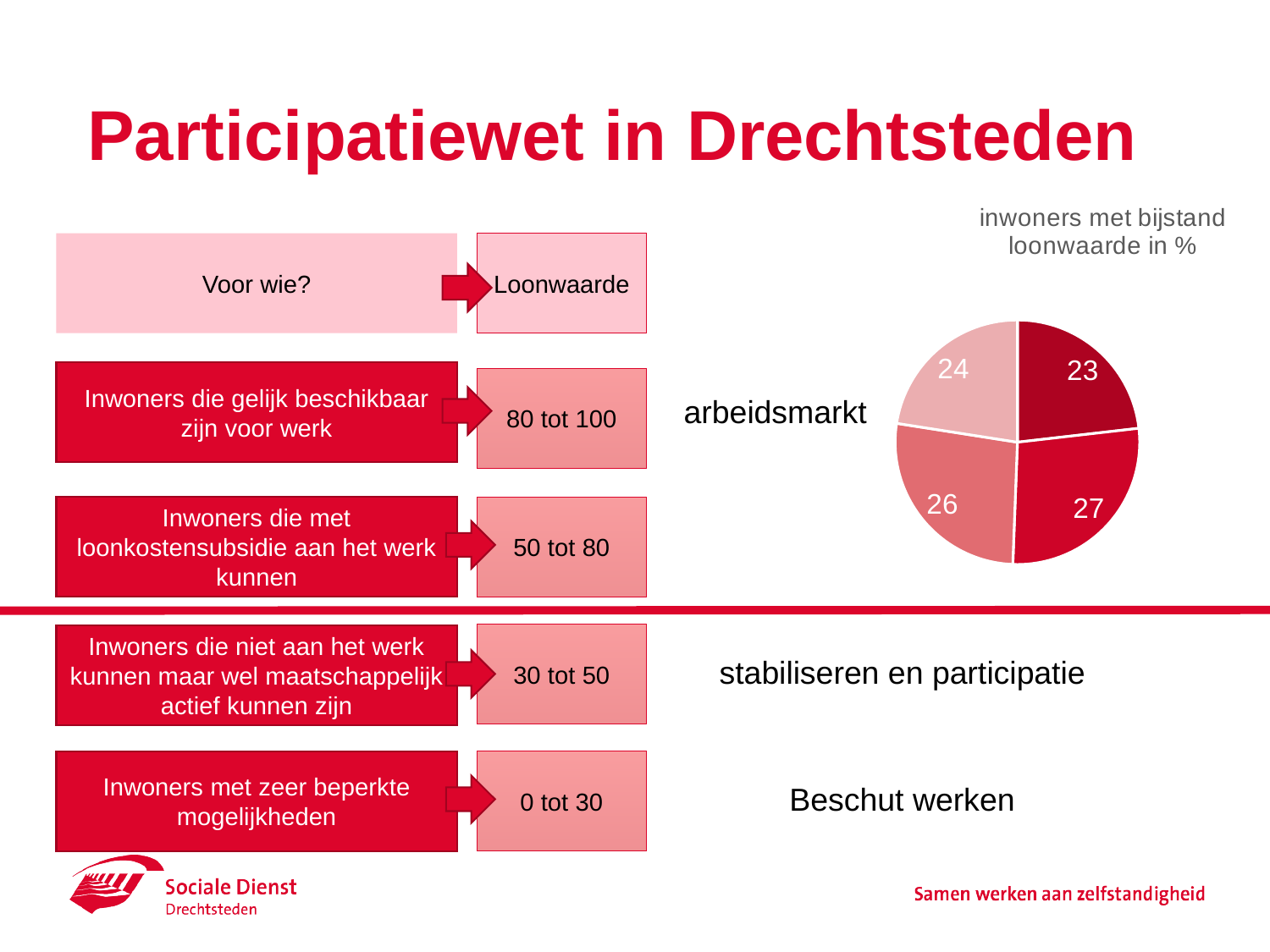
What is the difference between the two slices on the left side of the pie chart (26 and 24)? 2 What is the largest value shown on the pie chart? 27 What is the total of all four slice values on the pie chart? 100 What is the value of the slice at the bottom left of the pie chart? 26 What kind of chart is shown on the right of the slide? pie chart What is the difference between the largest and smallest slice values on the pie chart? 4 Which is larger on the pie chart: the bottom-right slice or the top-right slice? bottom-right slice (27) What is the smallest value shown on the pie chart? 23 What is the value of the darkest red slice at the top right of the pie chart? 23 How many slices does the pie chart have? 4 What is the value of the lightest pink slice at the top left of the pie chart? 24 What is the title of the pie chart? inwoners met bijstand loonwaarde in %